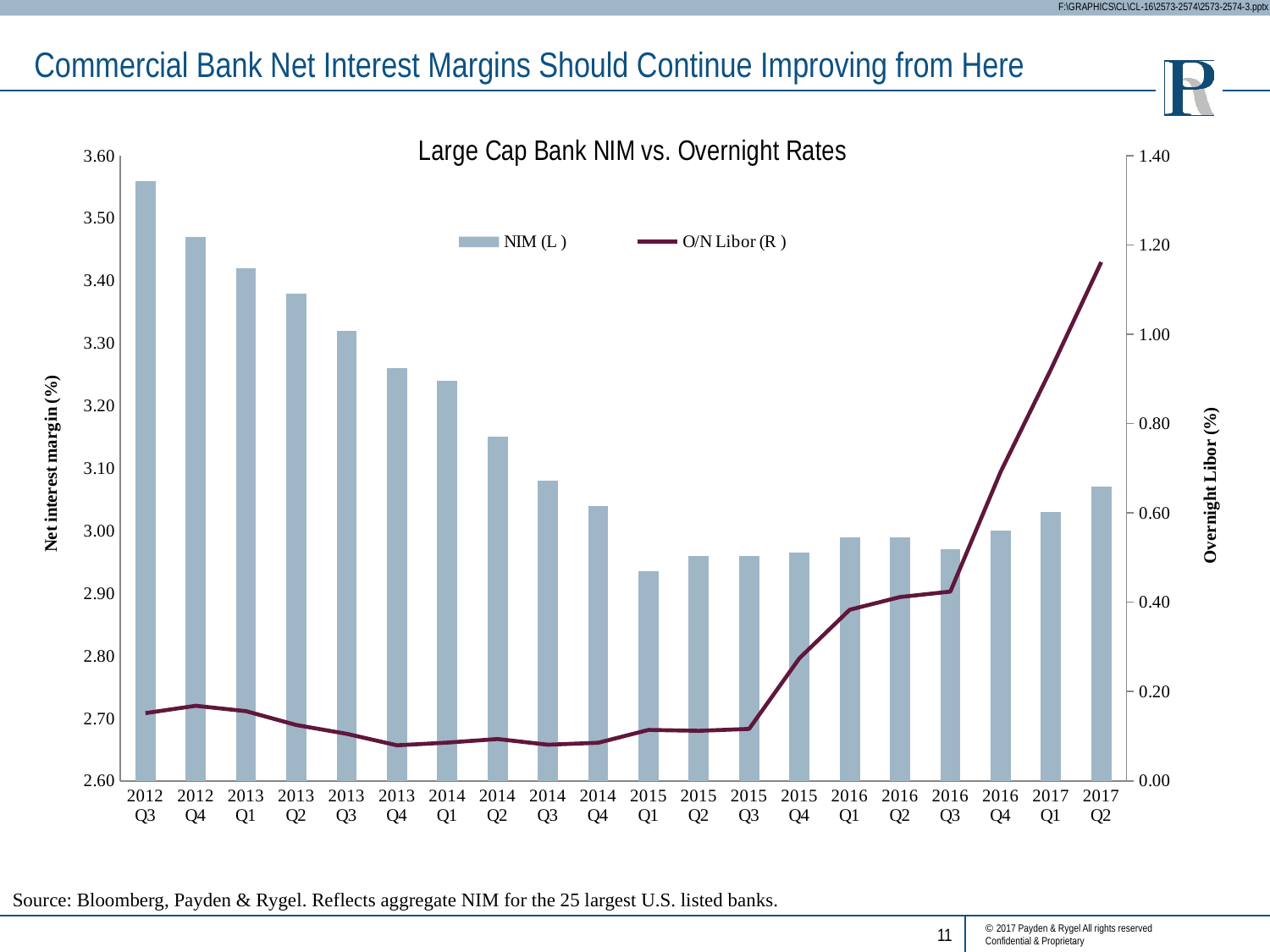
Which quarter has the lowest NIM (L) value? 2015 Q1 How many series does the chart legend list? 2 How many quarters are shown on the x axis? 20 Does the O/N Libor (R) line rise or fall from 2015 Q3 to 2017 Q2? rise Is the NIM (L) value for 2012 Q3 greater or less than 3.50? greater Is the O/N Libor (R) value for 2017 Q2 greater or less than 1.00? greater Is the O/N Libor (R) value for 2013 Q4 greater or less than 0.20? less Which is larger, the NIM (L) value for 2012 Q3 or for 2017 Q2? 2012 Q3 What is the title of the chart? Large Cap Bank NIM vs. Overnight Rates Which quarter has the highest NIM (L) value? 2012 Q3 What kind of chart is used to show the NIM (L) series? Bar chart